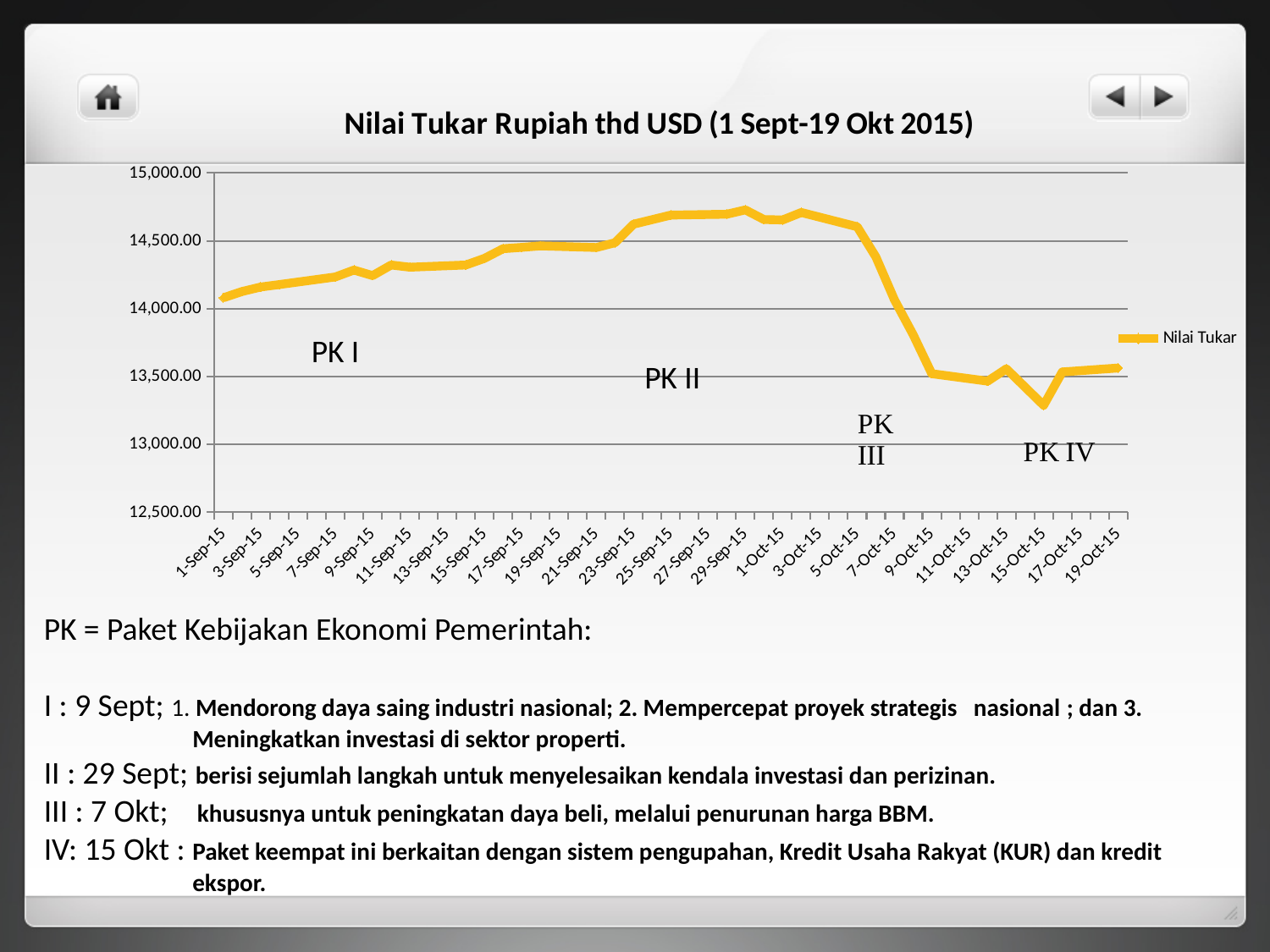
On which date does the line reach its lowest value? 15-Oct-15 Does the line generally rise or fall between 1-Sep-15 and 29-Sep-15? rise Does the line rise or fall between 5-Oct-15 and 9-Oct-15? fall Is the value for 1-Sep-15 greater or less than 14,000.00? greater Which is higher, the value for 1-Sep-15 or the value for 19-Oct-15? 1-Sep-15 What is the name of the series shown in the legend? Nilai Tukar What is the title of the chart? Nilai Tukar Rupiah thd USD (1 Sept-19 Okt 2015) Is the value for 19-Oct-15 greater or less than 14,000.00? less How many series does the legend list? 1 Is the value for 29-Sep-15 greater or less than 14,500.00? greater What kind of chart is shown on the slide? line chart